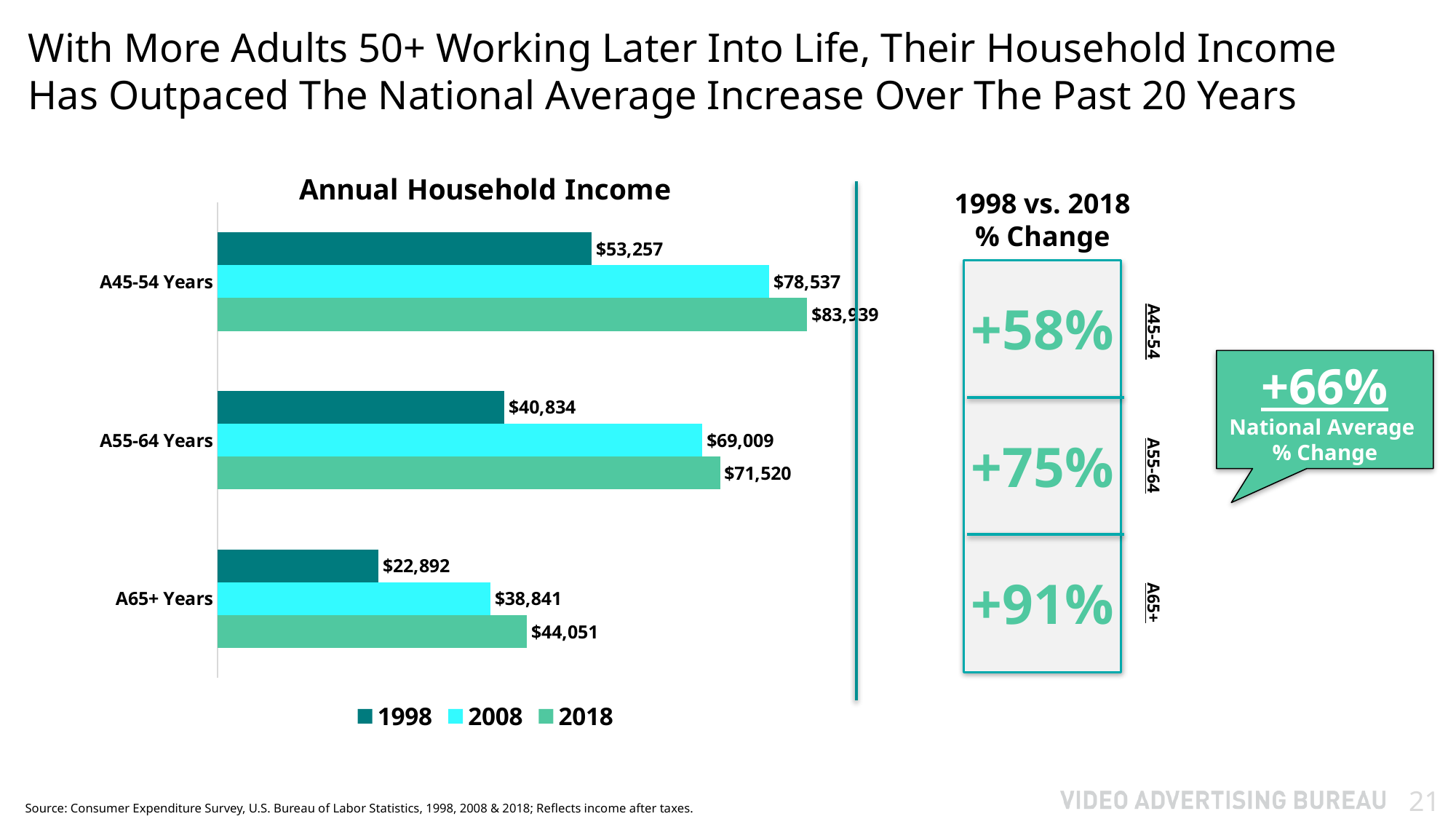
How many series does the legend of the Annual Household Income chart list? 3 Which age group has the lowest 1998 annual household income? A65+ Years What is the title of the chart on the left of the slide? Annual Household Income What kind of chart is the Annual Household Income chart? Bar chart What is the difference between the 2018 and 1998 annual household income for A55-64 Years? $30,686 How many age groups are shown in the Annual Household Income chart? 3 Which is larger: the 2008 income for A45-54 Years or the 2018 income for A55-64 Years? 2008 income for A45-54 Years What is the 1998 annual household income for A65+ Years? $22,892 What is the 2018 annual household income for A45-54 Years? $83,939 What is the 2008 annual household income for A55-64 Years? $69,009 Which age group has the highest 2018 annual household income? A45-54 Years What is the 1998 vs. 2018 % change for A65+? +91%